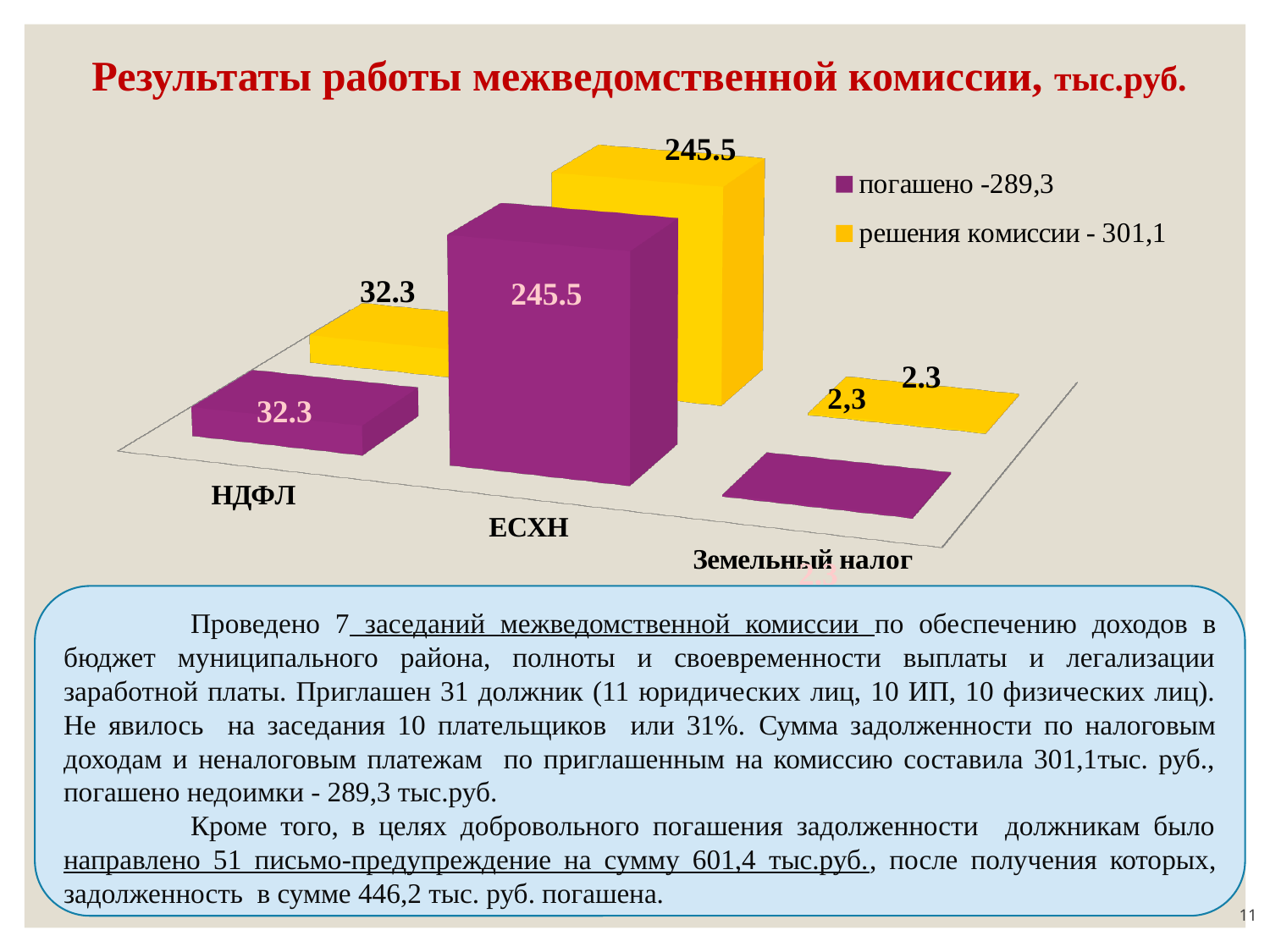
What is the title of the chart? Результаты работы межведомственной комиссии, тыс.руб. What is the difference between the 'решения комиссии' values for ЕСХН and НДФЛ? 213.2 Which category has the highest value for 'решения комиссии'? ЕСХН What type of chart is shown on the slide? bar chart What is the value of 'погашено' for ЕСХН? 245.5 What is the value of 'погашено' for НДФЛ? 32.3 What is the value of 'решения комиссии' for Земельный налог? 2.3 How many series does the chart legend list? 2 Which category has the lowest value for 'погашено'? Земельный налог How many categories are shown on the x axis of the chart? 3 What is the value of 'решения комиссии' for ЕСХН? 245.5 Which is larger: the 'решения комиссии' value for НДФЛ or for Земельный налог? НДФЛ